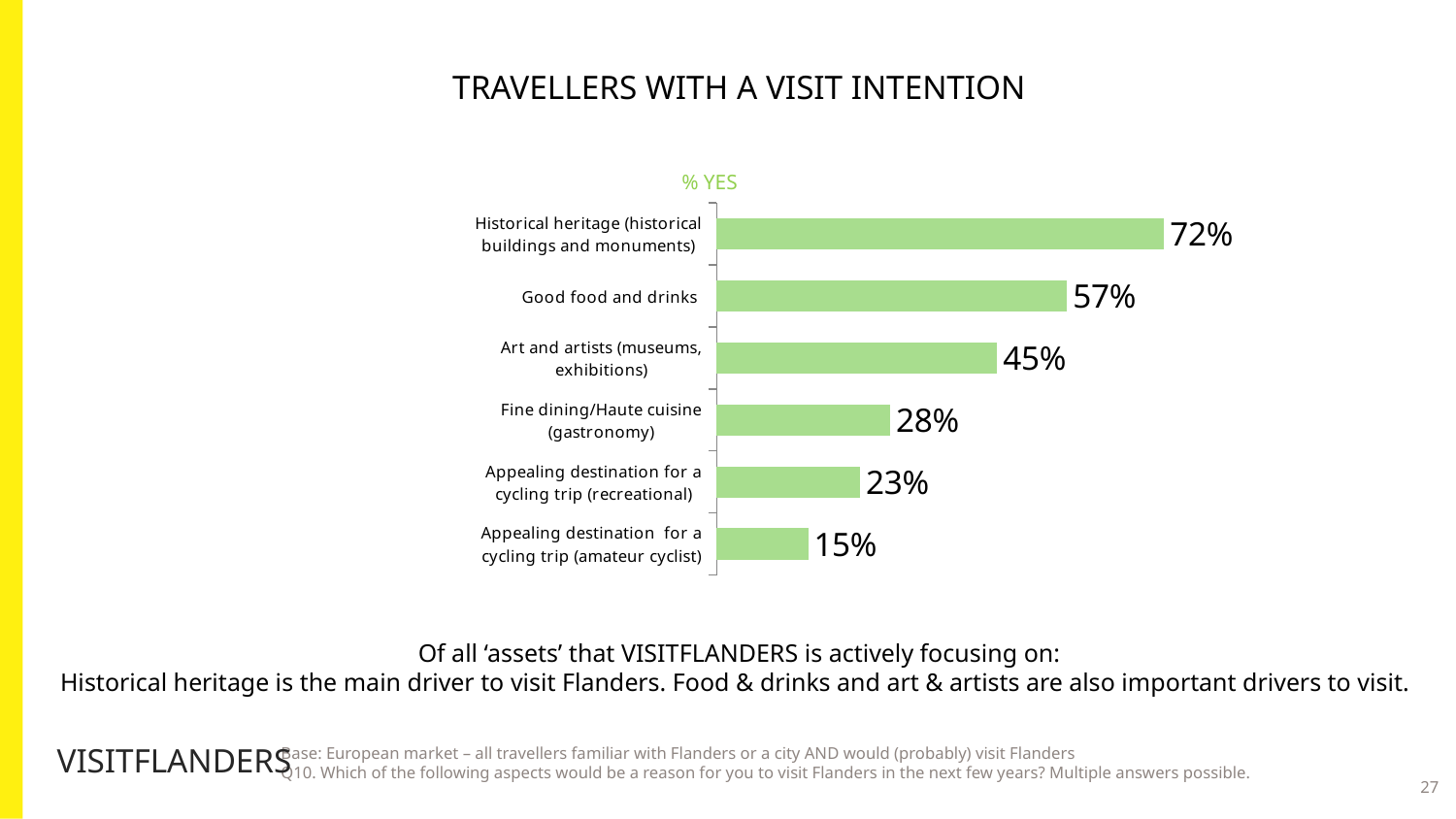
What kind of chart is shown on the slide? Bar chart What is the label shown above the chart in green? % YES Which category has the highest % YES? Historical heritage (historical buildings and monuments) What is the difference between the values for Art and artists (museums, exhibitions) and Fine dining/Haute cuisine (gastronomy)? 17% What is the value for Fine dining/Haute cuisine (gastronomy)? 28% What is the value for Good food and drinks? 57% What is the value for Appealing destination for a cycling trip (amateur cyclist)? 15% What percentage of travellers with a visit intention said yes to Historical heritage (historical buildings and monuments)? 72% Which category has the lowest % YES? Appealing destination for a cycling trip (amateur cyclist) How many categories are shown in the chart? 6 Which is larger: the value for Appealing destination for a cycling trip (recreational) or for Appealing destination for a cycling trip (amateur cyclist)? Appealing destination for a cycling trip (recreational) What is the difference between the values for Historical heritage and Good food and drinks? 15%